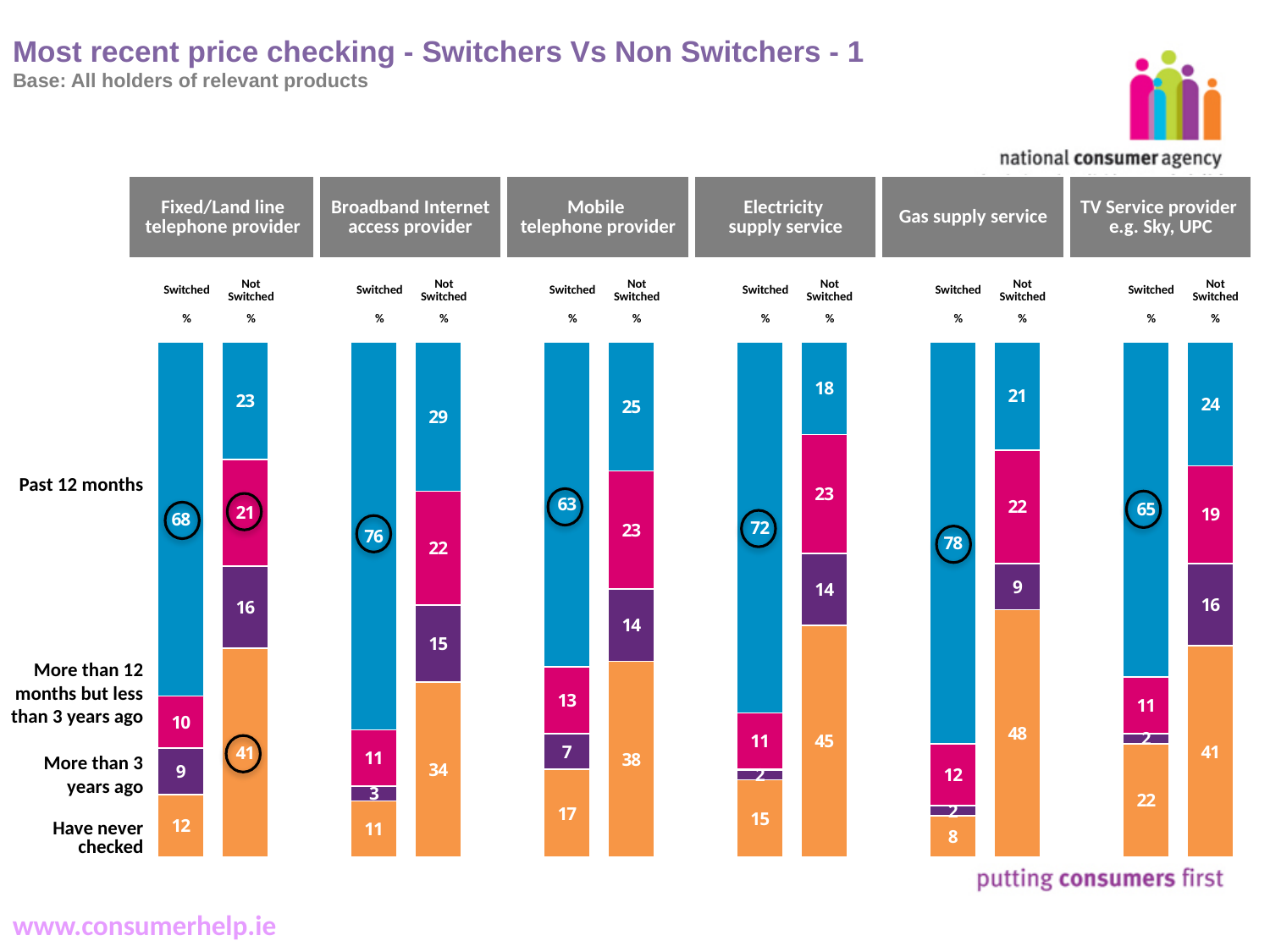
What percentage of Gas supply service customers who did not switch have never checked prices? 48 For the Fixed/Land line telephone provider, what is the difference between the Switched and Not Switched percentages for 'Past 12 months'? 47 Among the Switched bars, which product has the highest percentage for 'Past 12 months'? Gas supply service What kind of chart is shown on the slide? Stacked bar chart Among the Switched bars, which product has the lowest percentage for 'Have never checked'? Gas supply service What is the difference between the Switched and Not Switched percentages for 'Have never checked' for the TV Service provider? 19 What percentage of Mobile telephone provider customers who did not switch checked prices more than 12 months but less than 3 years ago? 23 What is the total of the Switched bar for the Fixed/Land line telephone provider? 99 What is the title of the chart on the slide? Most recent price checking - Switchers Vs Non Switchers - 1 What percentage of Fixed/Land line telephone provider customers who switched checked prices in the past 12 months? 68 How many product categories are shown on the chart? 6 For the Electricity supply service, which is larger: the Not Switched percentage for 'Have never checked' or the Not Switched percentage for 'Past 12 months'? Have never checked